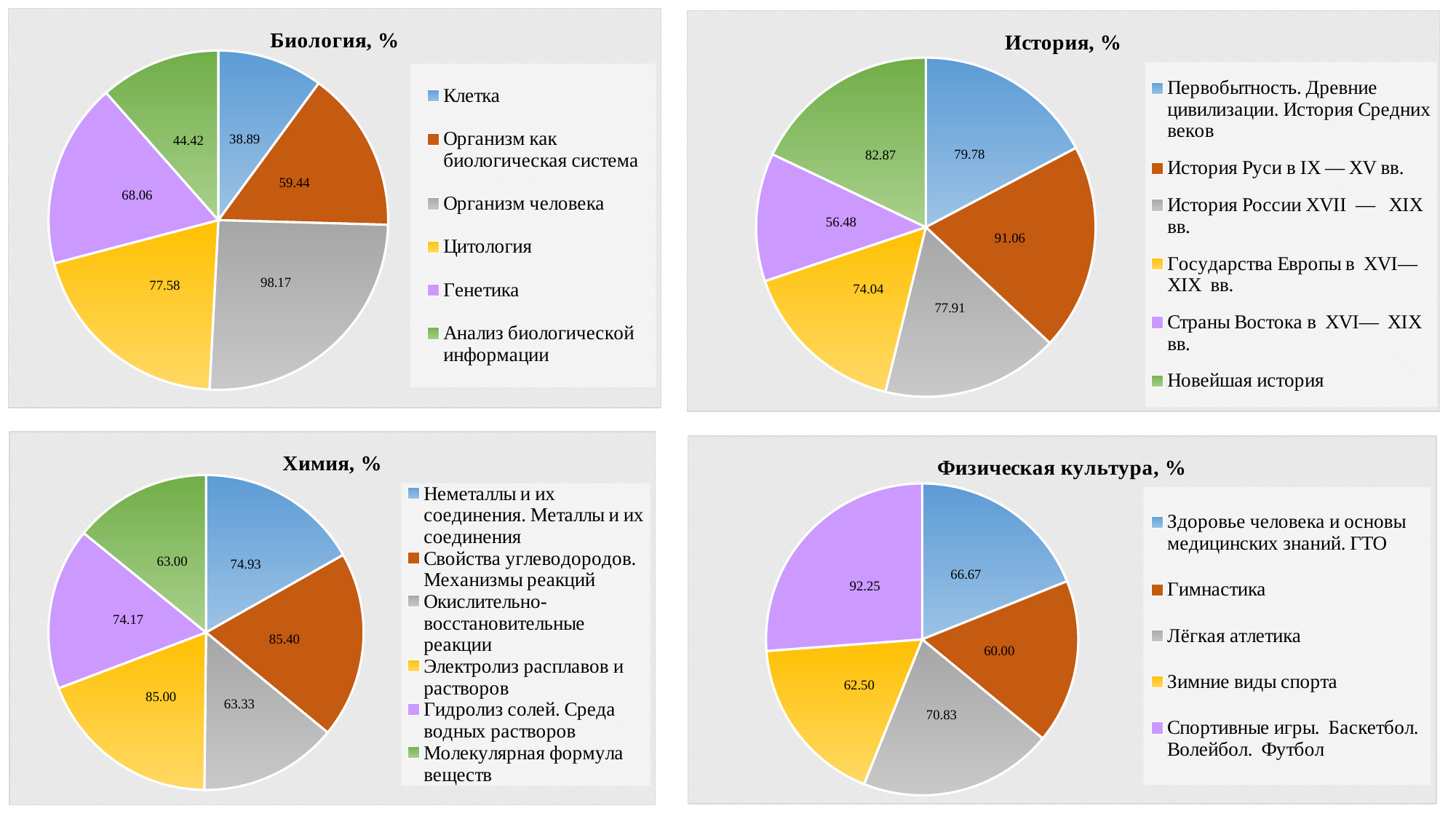
How many categories does the 'Физическая культура, %' chart show? 5 What type of chart is the 'Химия, %' chart? Pie chart In the 'Химия, %' chart, what is the value for Гидролиз солей. Среда водных растворов? 74.17 In the 'История, %' chart, which category has the lowest value? Страны Востока в XVI— XIX вв. In the 'Биология, %' chart, which category has the highest value? Организм человека In the 'Биология, %' chart, which category has the lowest value? Клетка In the 'История, %' chart, what is the value for Новейшая история? 82.87 In the 'Физическая культура, %' chart, what is the value for Лёгкая атлетика? 70.83 In the 'Биология, %' chart, what is the value for Генетика? 68.06 In the 'Химия, %' chart, which is larger: the value for Электролиз расплавов и растворов or the value for Окислительно-восстановительные реакции? Электролиз расплавов и растворов In the 'Физическая культура, %' chart, which category has the highest value? Спортивные игры. Баскетбол. Волейбол. Футбол In the 'История, %' chart, what is the difference between the values for История Руси в IX — XV вв. and Государства Европы в XVI—XIX вв.? 17.02